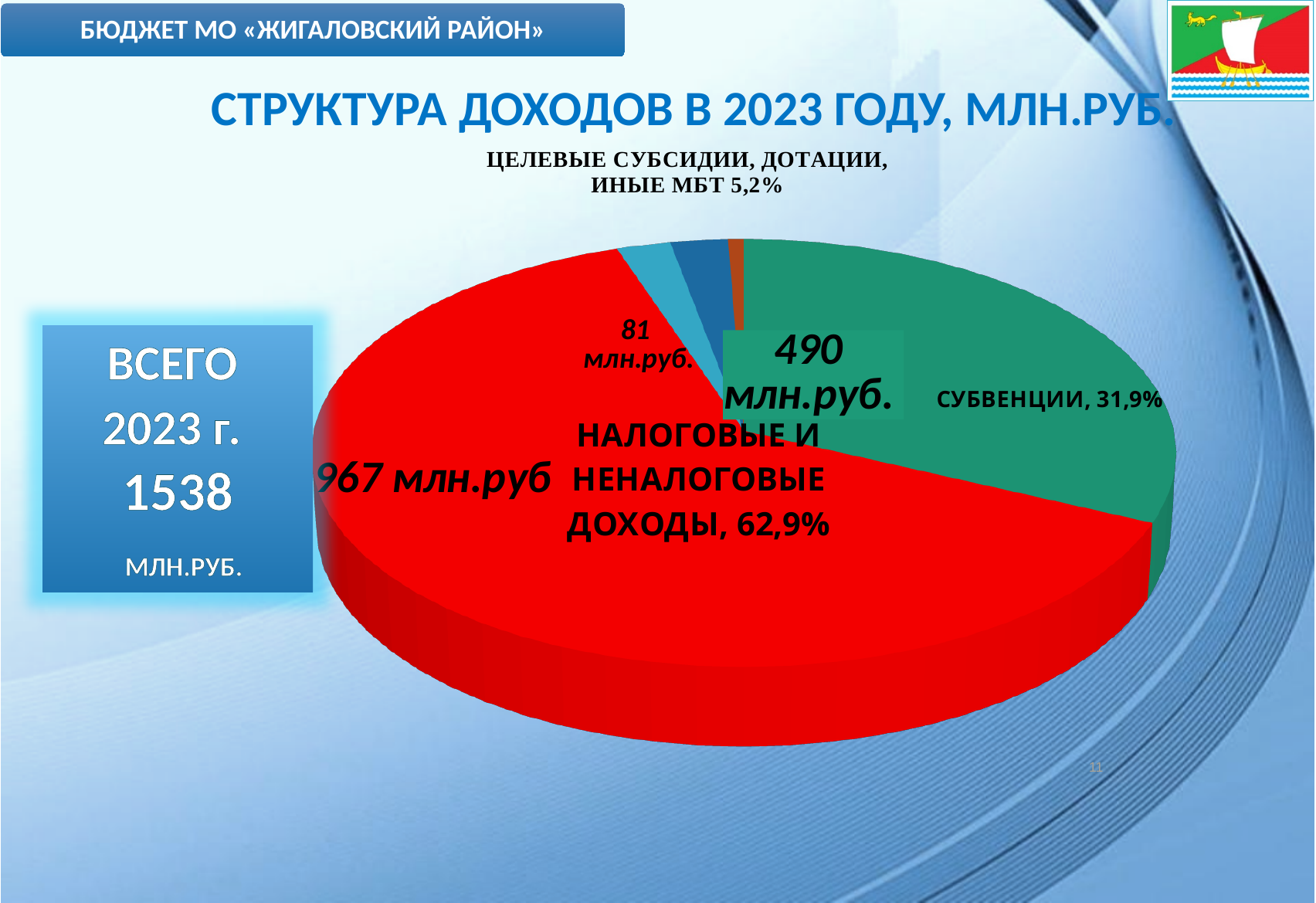
What is the value for СУБВЕНЦИИ? 490 млн.руб. What is the value for НАЛОГОВЫЕ И НЕНАЛОГОВЫЕ ДОХОДЫ? 967 млн.руб What share of the pie does ЦЕЛЕВЫЕ СУБСИДИИ, ДОТАЦИИ, ИНЫЕ МБТ represent? 5,2% What is the title of the chart on the slide? СТРУКТУРА ДОХОДОВ В 2023 ГОДУ, МЛН.РУБ. What is the value for ЦЕЛЕВЫЕ СУБСИДИИ, ДОТАЦИИ, ИНЫЕ МБТ? 81 млн.руб. Which category has the largest share of the pie? НАЛОГОВЫЕ И НЕНАЛОГОВЫЕ ДОХОДЫ What is the difference in млн.руб. between НАЛОГОВЫЕ И НЕНАЛОГОВЫЕ ДОХОДЫ and СУБВЕНЦИИ? 477 млн.руб. What kind of chart is shown on the slide? pie chart Which labelled category has the smallest share of the pie? ЦЕЛЕВЫЕ СУБСИДИИ, ДОТАЦИИ, ИНЫЕ МБТ What share of the pie does НАЛОГОВЫЕ И НЕНАЛОГОВЫЕ ДОХОДЫ represent? 62,9% Which is larger, the value for СУБВЕНЦИИ or the value for ЦЕЛЕВЫЕ СУБСИДИИ, ДОТАЦИИ, ИНЫЕ МБТ? СУБВЕНЦИИ What share of the pie does СУБВЕНЦИИ represent? 31,9%